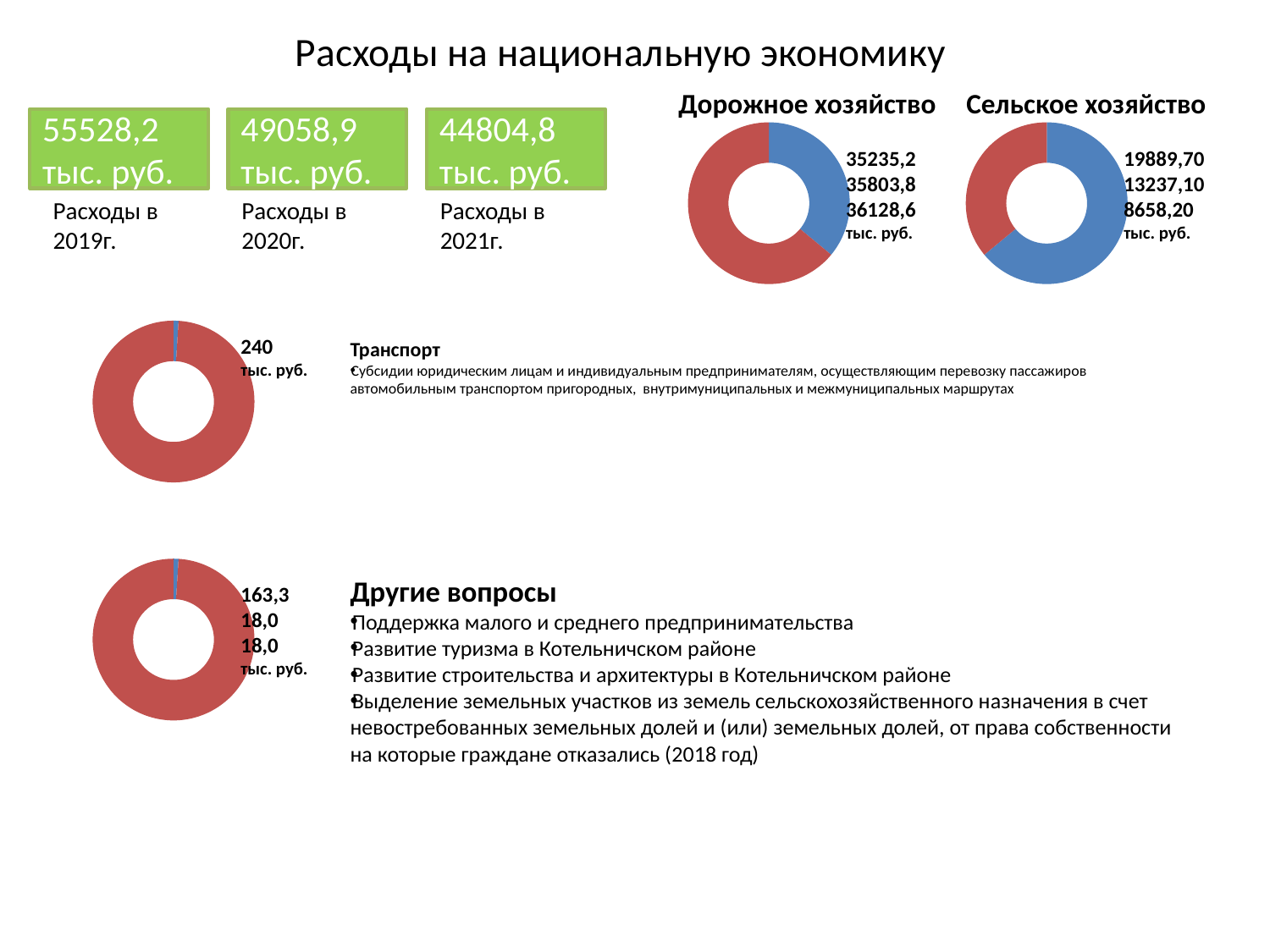
How many slices does the "Дорожное хозяйство" doughnut chart have? 2 What kind of chart is shown next to the "Другие вопросы" text? doughnut chart What is the title of the doughnut chart in the top right corner of the slide? Сельское хозяйство In the "Дорожное хозяйство" chart, which slice is larger, the red one or the blue one? red In the doughnut chart next to the "Другие вопросы" text, which slice is larger, the red one or the blue one? red In the doughnut chart next to the "Транспорт" text, which slice is larger, the red one or the blue one? red How many slices does the "Сельское хозяйство" doughnut chart have? 2 What kind of chart is shown under the heading "Дорожное хозяйство"? doughnut chart How many doughnut charts are on the slide? 4